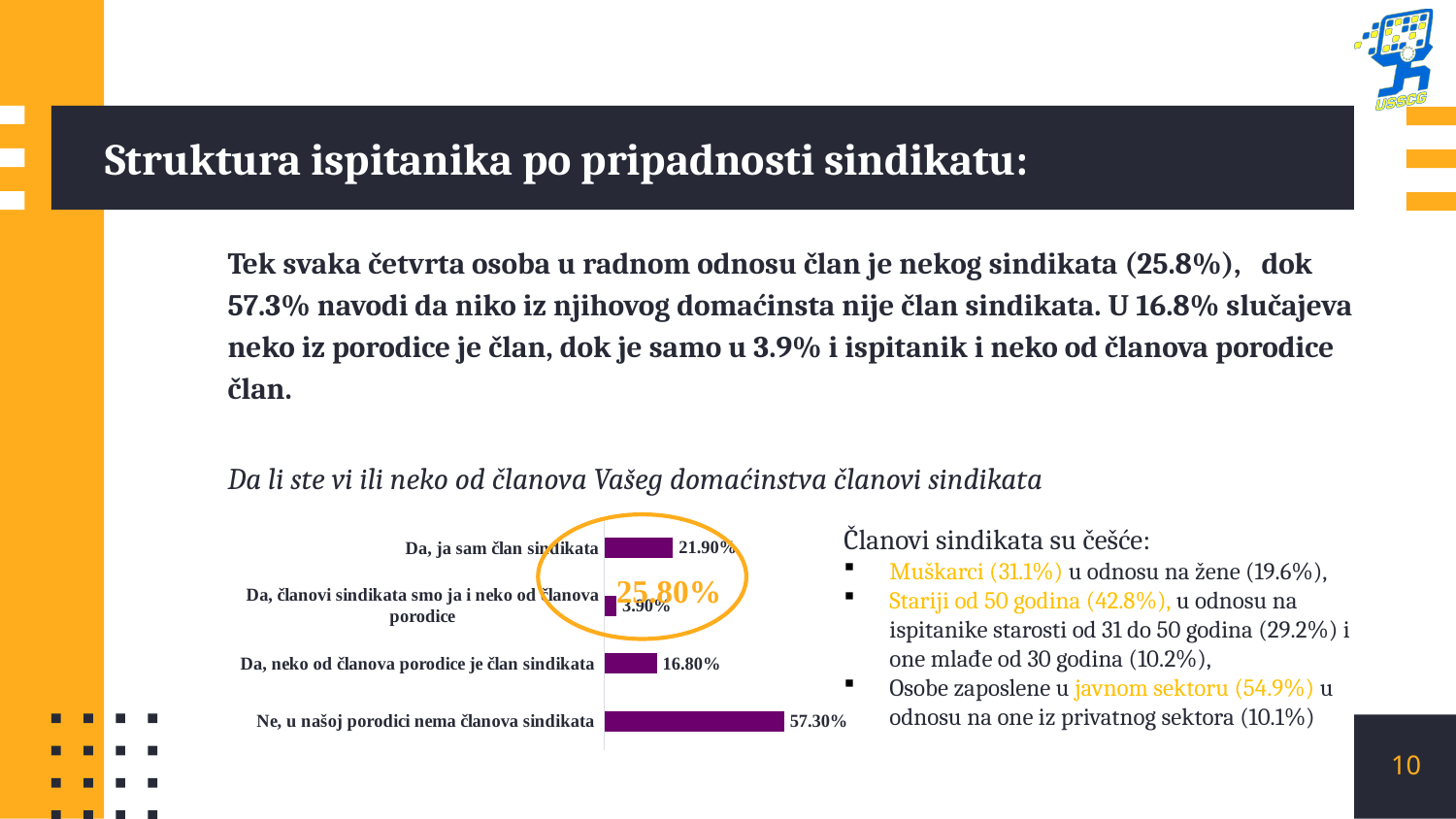
Which category has the highest value in the chart? Ne, u našoj porodici nema članova sindikata How many categories are shown in the chart? 4 What kind of chart is shown on the slide? Bar chart What value is shown for "Da, članovi sindikata smo ja i neko od članova porodice"? 3.90% What is the title of the chart? Da li ste vi ili neko od članova Vašeg domaćinstva članovi sindikata What value is shown for "Ne, u našoj porodici nema članova sindikata"? 57.30% What value is shown for "Da, neko od članova porodice je član sindikata"? 16.80% What value is shown for "Da, ja sam član sindikata"? 21.90% What is the difference between the values for "Da, ja sam član sindikata" and "Da, neko od članova porodice je član sindikata"? 5.10% What is the difference between the values for "Ne, u našoj porodici nema članova sindikata" and "Da, ja sam član sindikata"? 35.40% Which category has the lowest value in the chart? Da, članovi sindikata smo ja i neko od članova porodice Which is larger: the value for "Da, ja sam član sindikata" or for "Da, neko od članova porodice je član sindikata"? Da, ja sam član sindikata